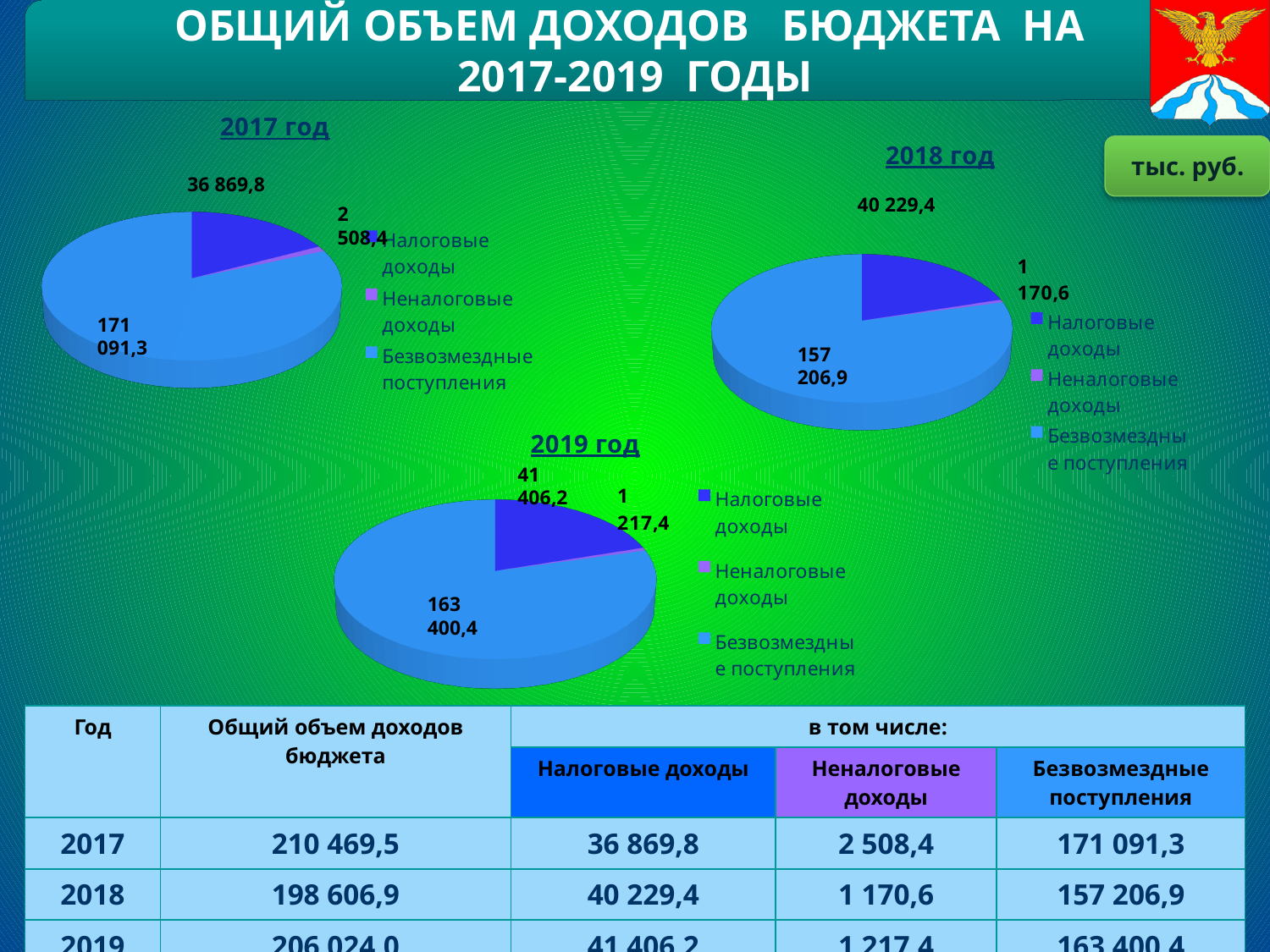
On the 2017 год pie chart, what is the value for Налоговые доходы? 36 869,8 On the 2018 год pie chart, what is the value for Неналоговые доходы? 1 170,6 On the 2019 год pie chart, what is the value for Налоговые доходы? 41 406,2 On the 2017 год pie chart, what is the value for Безвозмездные поступления? 171 091,3 On the 2018 год pie chart, which category has the largest slice? Безвозмездные поступления On the 2017 год pie chart, what is the difference between Налоговые доходы and Неналоговые доходы? 34 361,4 On the 2018 год pie chart, what is the difference between Безвозмездные поступления and Налоговые доходы? 116 977,5 On the 2019 год pie chart, which is larger: Налоговые доходы or Неналоговые доходы? Налоговые доходы On the 2019 год pie chart, which category has the smallest slice? Неналоговые доходы What type of chart is used for the 2018 год data? Pie chart On the 2019 год pie chart, what is the value for Безвозмездные поступления? 163 400,4 How many slices does the 2017 год pie chart have? 3